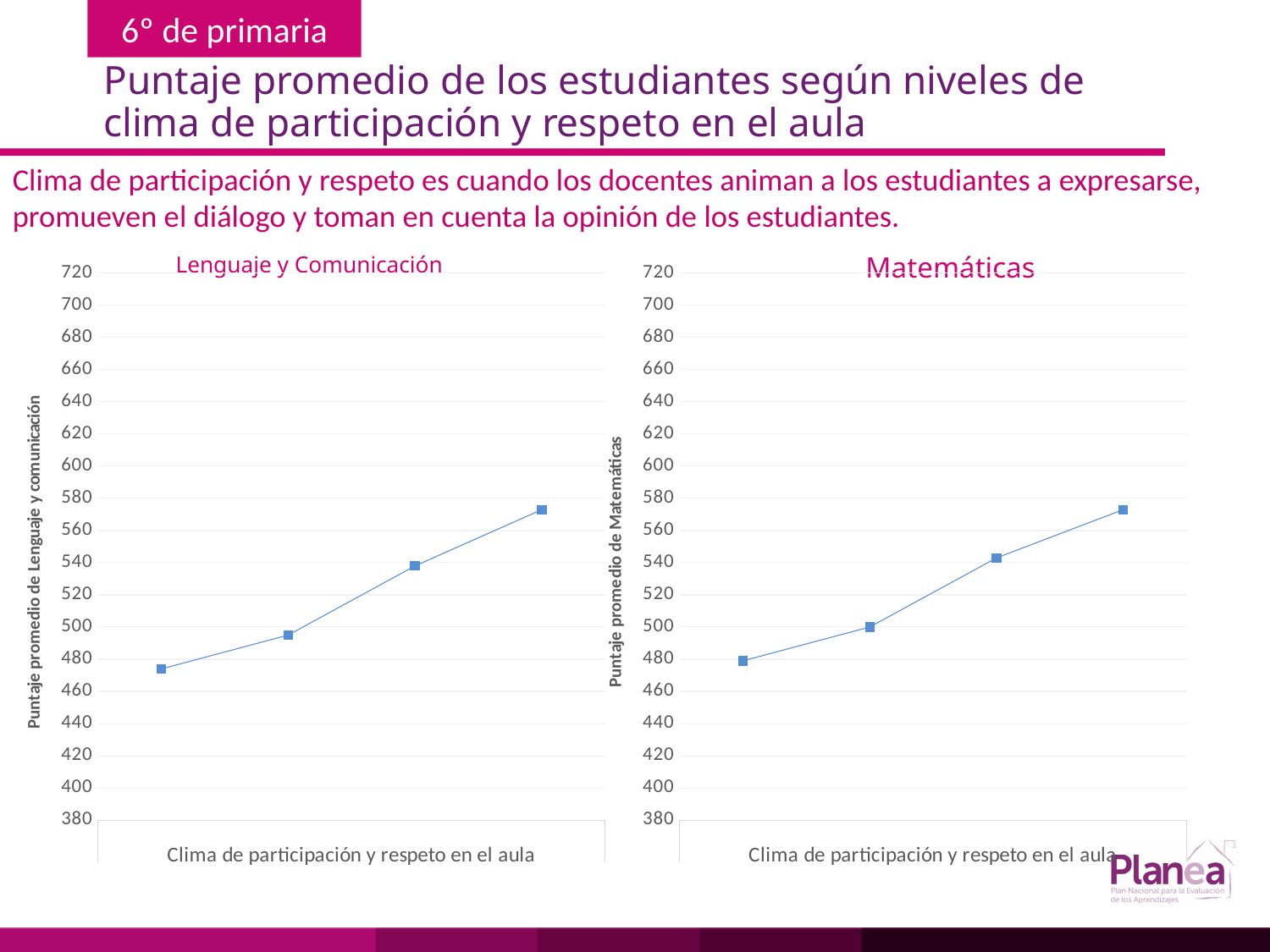
In the "Matemáticas" chart, is the value of the leftmost point greater or less than 500? less In the "Matemáticas" chart, which point has the lowest value, the leftmost or the rightmost? the leftmost What kind of chart is the "Lenguaje y Comunicación" chart? line chart In the "Lenguaje y Comunicación" chart, is the value of the leftmost point greater or less than 480? less In the "Lenguaje y Comunicación" chart, which point has the highest value, the leftmost or the rightmost? the rightmost In the "Lenguaje y Comunicación" chart, do the values rise or fall from left to right? rise How many data points are plotted in the "Matemáticas" chart? 4 What is the y-axis title of the "Lenguaje y Comunicación" chart? Puntaje promedio de Lenguaje y comunicación In the "Matemáticas" chart, do the values rise or fall from left to right? rise In the "Lenguaje y Comunicación" chart, is the value of the rightmost point greater or less than 560? greater What is the x-axis title of the "Matemáticas" chart? Clima de participación y respeto en el aula